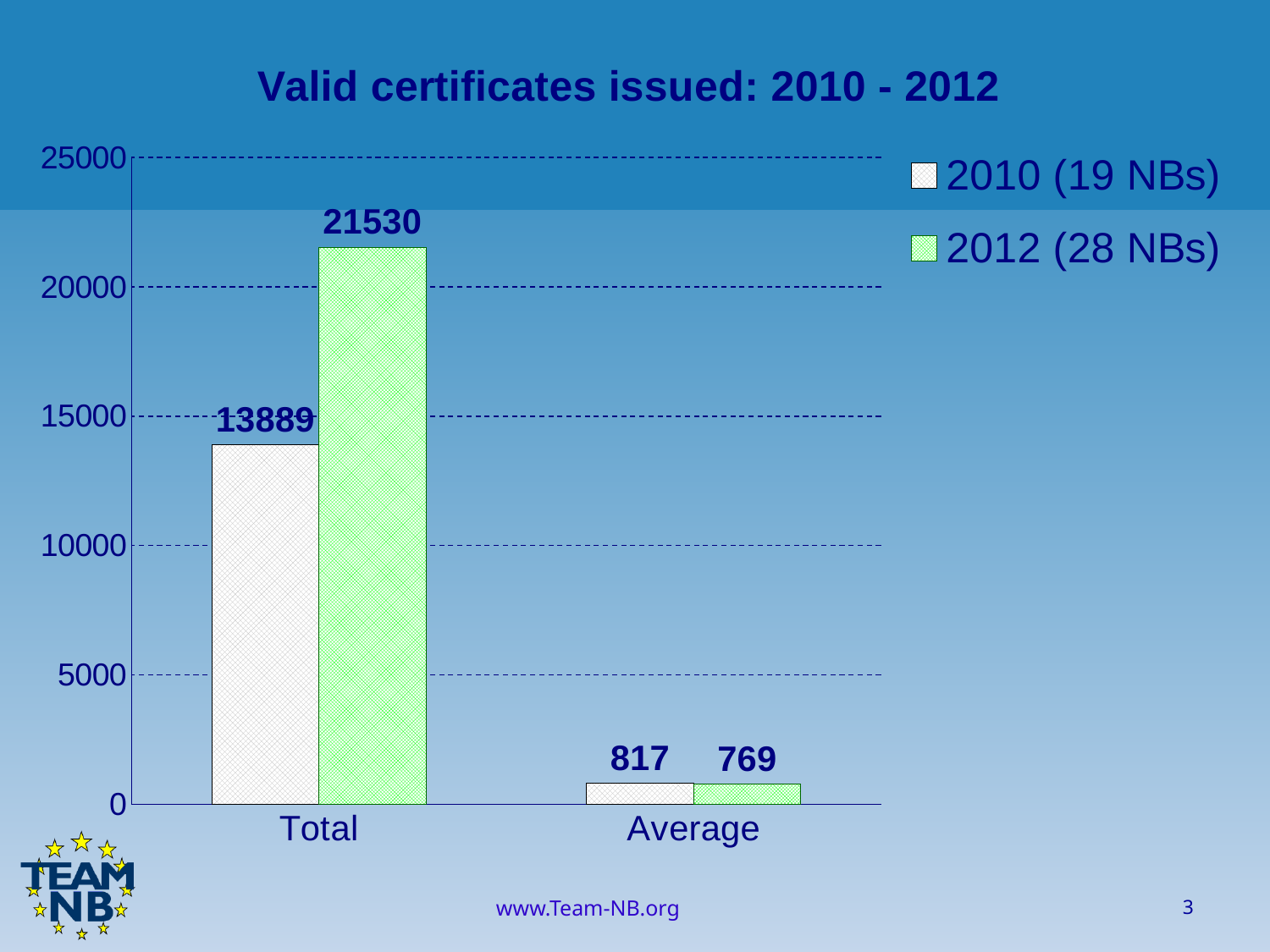
What is the title of the chart? Valid certificates issued: 2010 - 2012 What is the Total value for the 2010 (19 NBs) series? 13889 Which series has the larger Average value, 2010 (19 NBs) or 2012 (28 NBs)? 2010 (19 NBs) What is the difference between the 2012 (28 NBs) and 2010 (19 NBs) Total values? 7641 What is the Average value for the 2012 (28 NBs) series? 769 What kind of chart is shown on the slide? bar chart What is the Total value for the 2012 (28 NBs) series? 21530 What is the difference between the 2010 (19 NBs) and 2012 (28 NBs) Average values? 48 Is the Total value for 2012 (28 NBs) greater or less than 20000? greater Which series has the larger Total value, 2010 (19 NBs) or 2012 (28 NBs)? 2012 (28 NBs) How many series does the legend list? 2 What is the Average value for the 2010 (19 NBs) series? 817